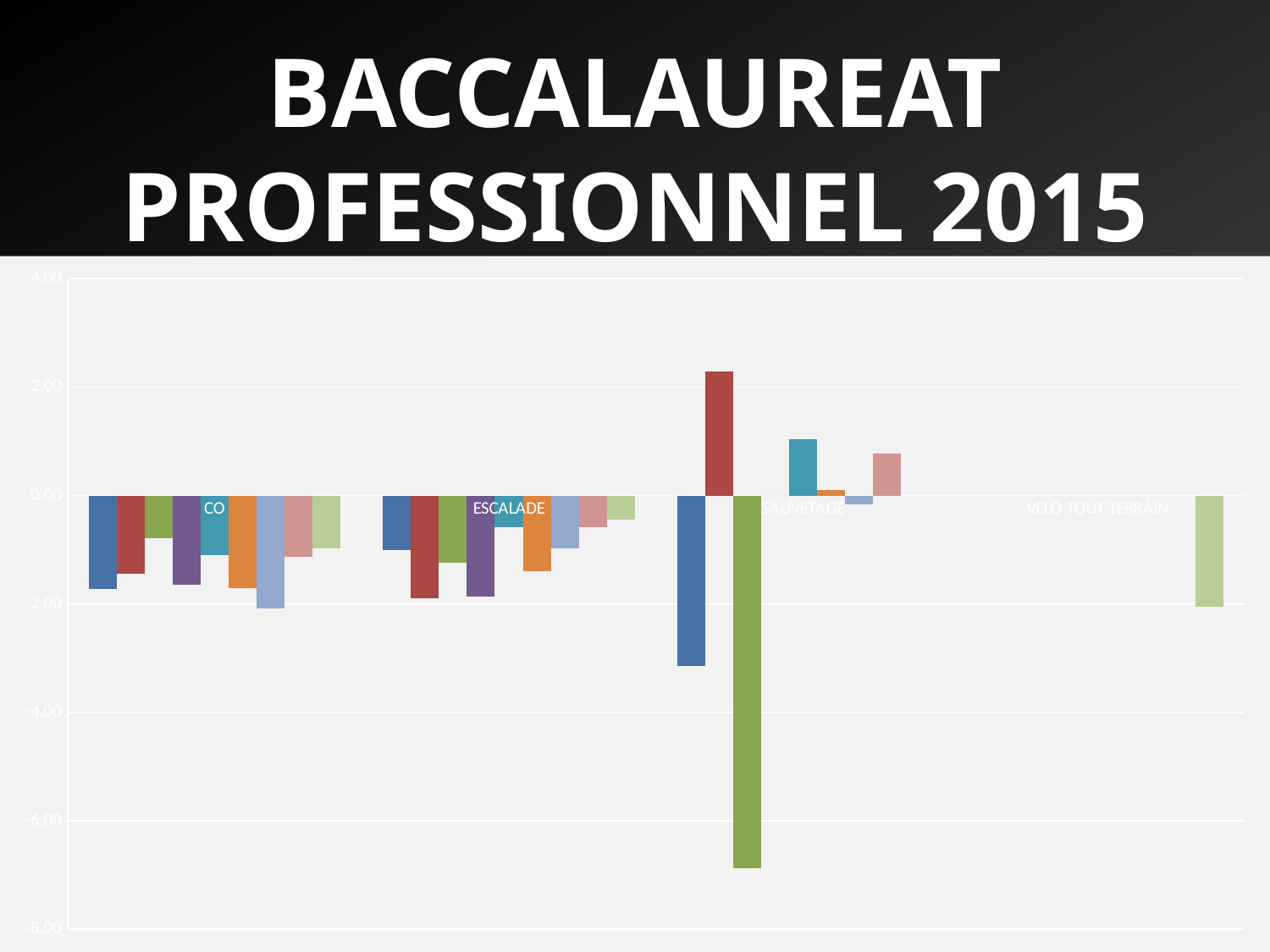
Is the bar for VELO TOUT TERRAIN positive or negative? negative What is the title shown above the chart? BACCALAUREAT PROFESSIONNEL 2015 How many categories are labelled on the x axis of the chart? 4 Is the value of the lowest bar in SAUVETAGE greater or less than -6.00? less Is the value of the tallest positive bar in SAUVETAGE greater or less than 2.00? greater What kind of chart is shown on the slide? bar chart What is the highest value shown on the vertical axis? 4.00 Which category contains the lowest bar in the chart? SAUVETAGE How many bars are plotted for VELO TOUT TERRAIN? 1 Which category contains the highest bar in the chart? SAUVETAGE